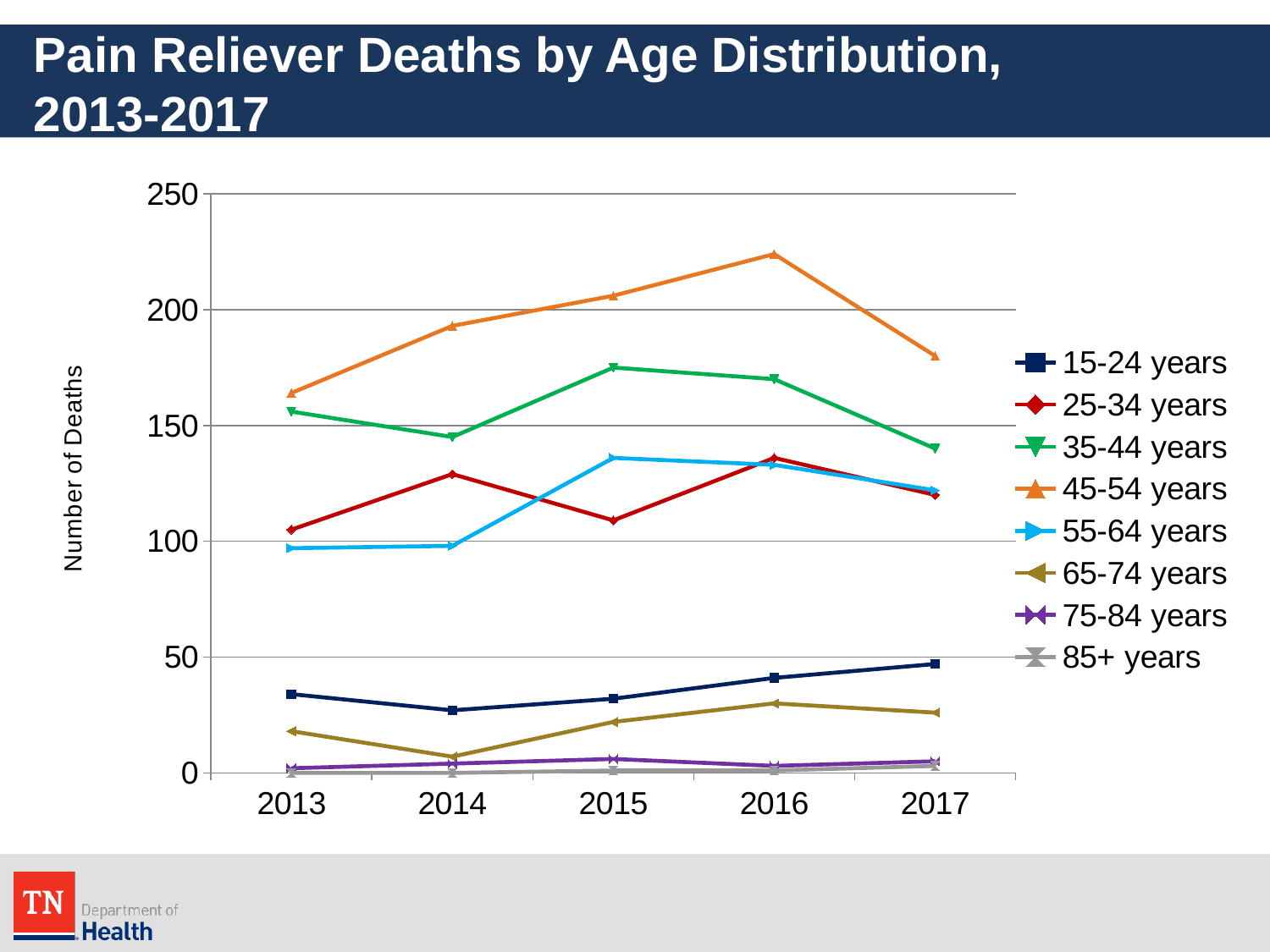
Is the value for 65-74 years in 2016 greater or less than 50? less What kind of chart is shown on the slide? line chart Is the value for 25-34 years in 2014 greater or less than 100? greater How many years are shown on the x axis? 5 Is the value for 45-54 years in 2016 greater or less than 200? greater Which age group had the lowest number of pain reliever deaths in 2015? 85+ years In 2017, which had more deaths: 35-44 years or 25-34 years? 35-44 years Did the number of deaths for 45-54 years rise or fall from 2016 to 2017? fall Did the number of deaths for 15-24 years rise or fall from 2014 to 2017? rise Which age group had the highest number of pain reliever deaths in 2016? 45-54 years What is the label on the y axis of the chart? Number of Deaths How many age groups does the legend list? 8